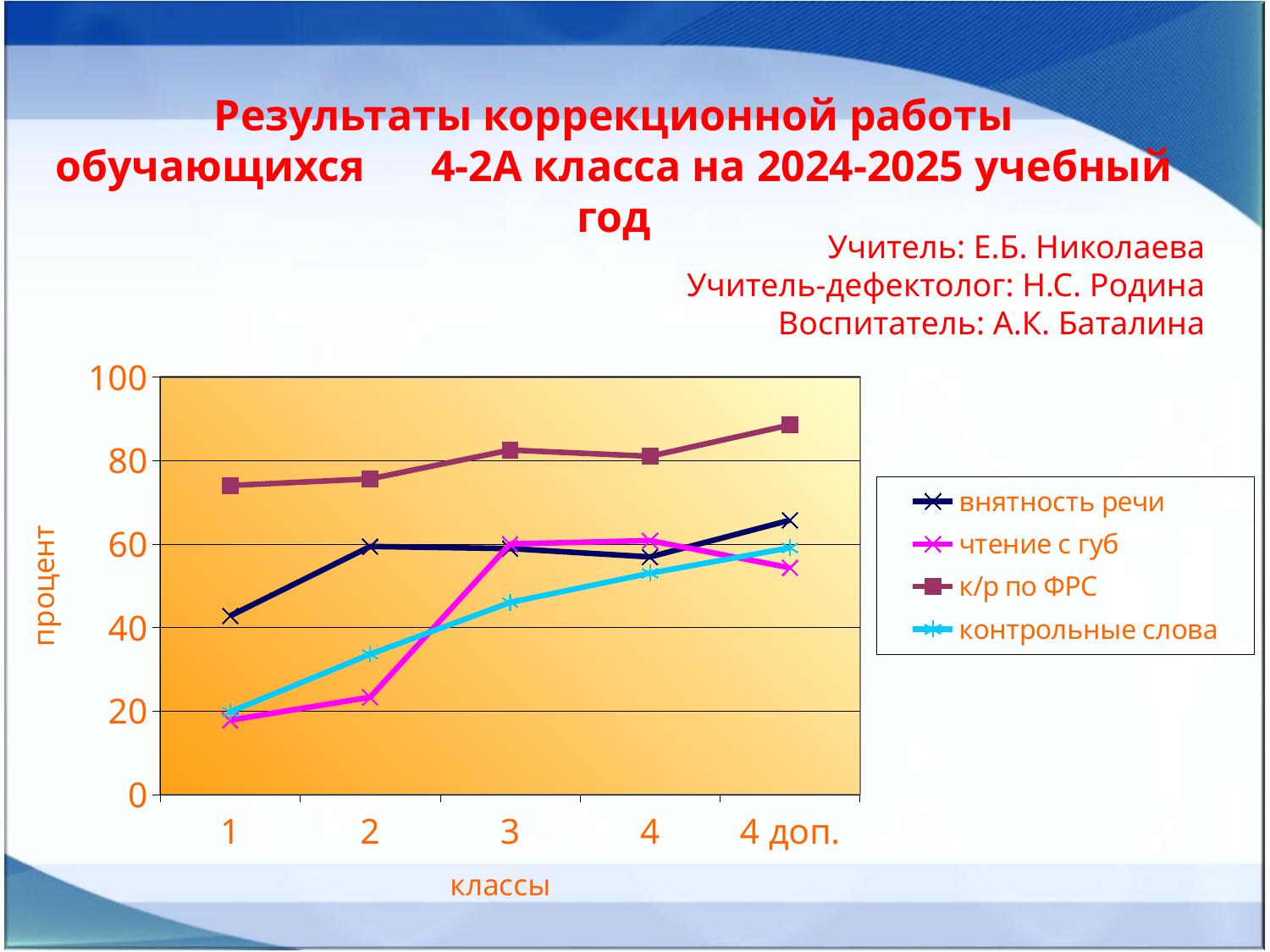
Is the value for к/р по ФРС at class 1 greater or less than 60? greater Is the value for чтение с губ at class 1 greater or less than 40? less Is the value for к/р по ФРС at 4 доп. greater or less than 80? greater What kind of chart is shown on the slide? line chart Which series has the highest value at class 3? к/р по ФРС Do the values for контрольные слова rise or fall from class 1 to 4 доп.? rise Which series has the lowest value at class 2? чтение с губ What is the title of the vertical axis? процент At class 4, which is larger: контрольные слова or к/р по ФРС? к/р по ФРС How many series does the legend list? 4 How many categories are shown on the x axis? 5